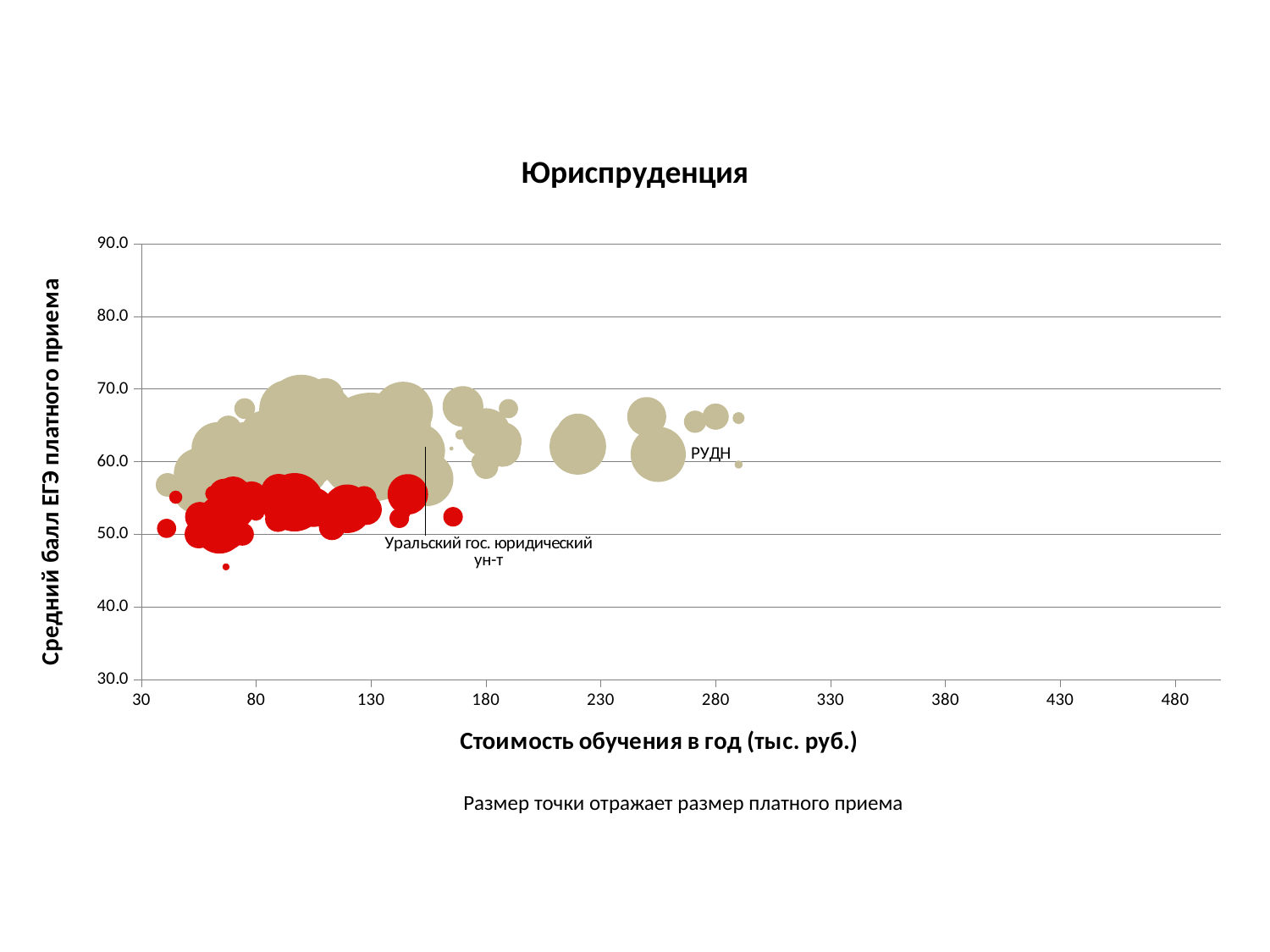
Is the average ЕГЭ score for РУДН greater or less than 50? greater Is the x-axis value (cost of tuition) for РУДН greater or less than 230? greater What is the label of the x axis of the chart? Стоимость обучения в год (тыс. руб.) What is the title of the chart? Юриспруденция Is the x-axis value (cost of tuition) for Уральский гос. юридический ун-т greater or less than 130? greater How many data points on the chart are labeled with a university name? 2 What is the highest value shown on the y axis of the chart? 90.0 What kind of chart is shown on the slide? bubble chart Which of the two labeled universities, РУДН or Уральский гос. юридический ун-т, has the higher tuition cost on the x axis? РУДН